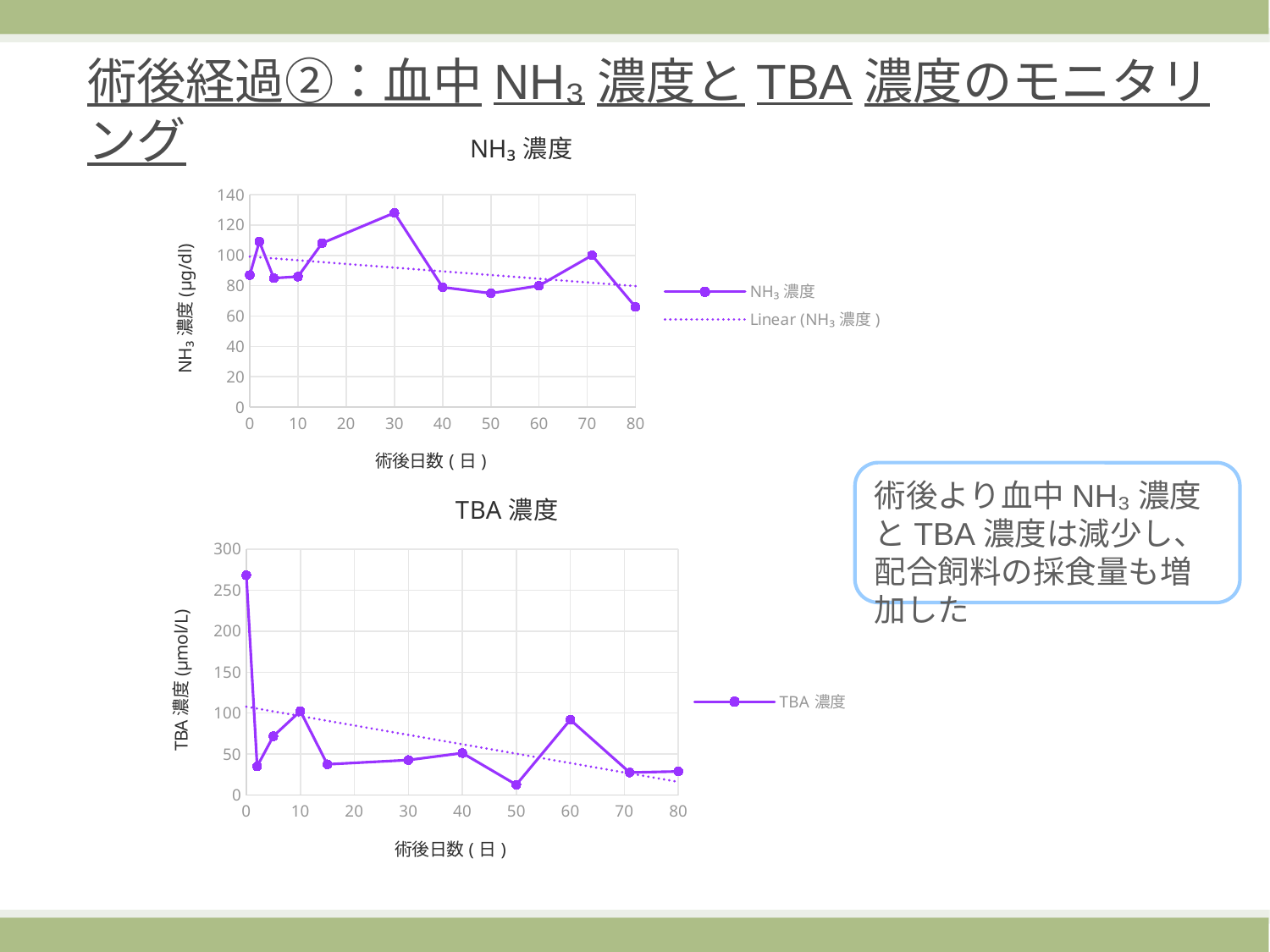
In the TBA 濃度 chart, which is larger, the value at day 60 or the value at day 50? day 60 What is the y-axis unit shown on the TBA 濃度 chart? μmol/L In the TBA 濃度 chart, at which postoperative day is the TBA concentration lowest? 50 In the TBA 濃度 chart, at which postoperative day is the TBA concentration highest? 0 In the NH₃ 濃度 chart, is the value at day 30 greater or less than 120? greater In the NH₃ 濃度 chart, at which postoperative day (術後日数) is the NH₃ concentration highest? 30 In the NH₃ 濃度 chart, does the dotted linear trend line rise or fall as postoperative days increase? fall How many entries does the legend of the NH₃ 濃度 chart list? 2 In the NH₃ 濃度 chart, at which postoperative day is the NH₃ concentration lowest? 80 In the TBA 濃度 chart, is the value at day 0 greater or less than 250? greater What type of chart is the NH₃ 濃度 chart? line chart In the NH₃ 濃度 chart, is the value at day 80 greater or less than 80? less